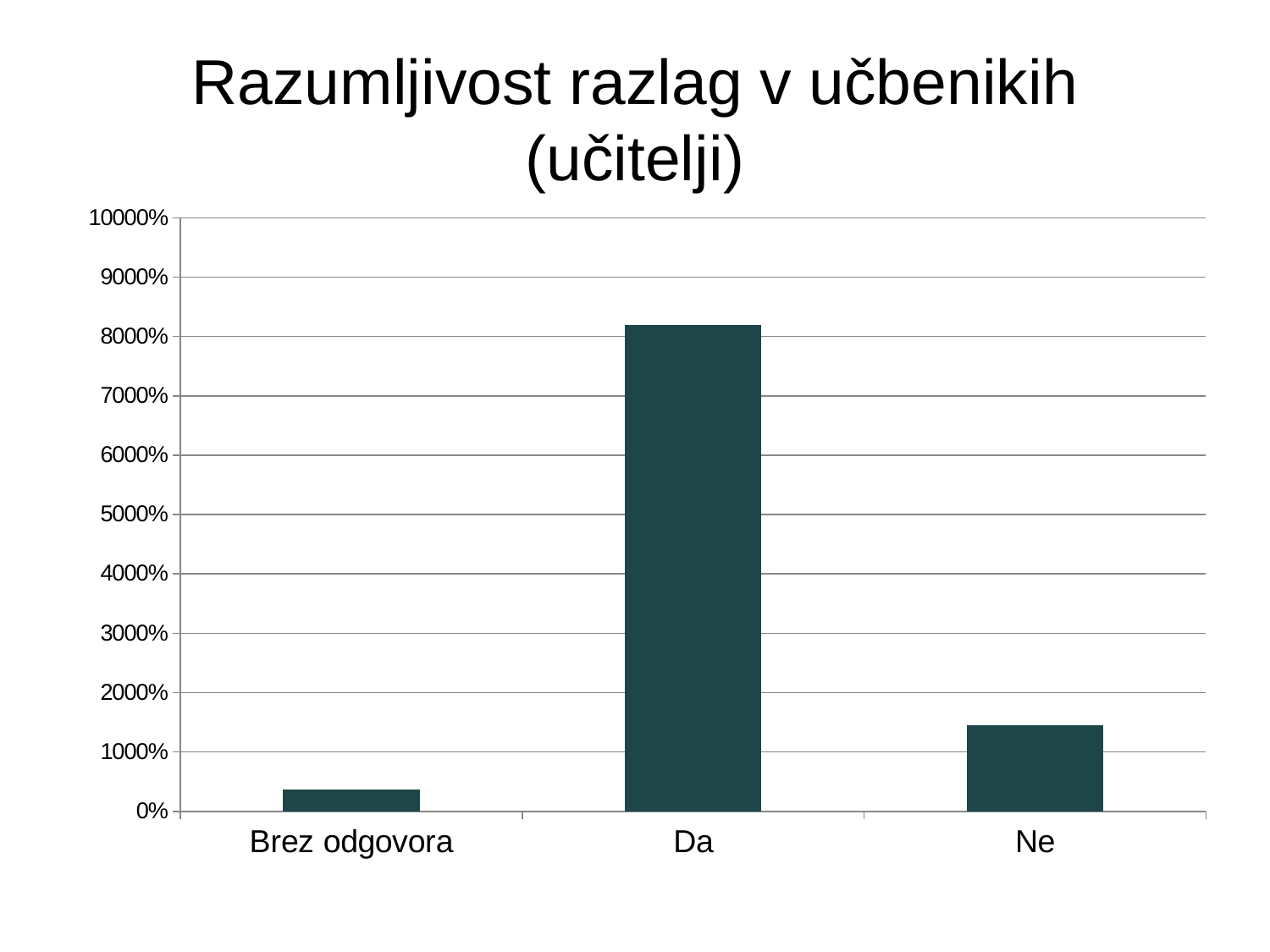
What kind of chart is shown on the slide? bar chart Which category has the lowest value in the chart? Brez odgovora Which category has the highest value in the chart? Da Is the value for Brez odgovora greater or less than 1000%? less Which is larger, the value for Da or the value for Ne? Da Is the value for Ne greater or less than 1000%? greater Is the value for Ne greater or less than 2000%? less Which is larger, the value for Ne or the value for Brez odgovora? Ne How many categories are shown on the x axis of the chart? 3 What is the title of the slide containing the chart? Razumljivost razlag v učbenikih (učitelji)